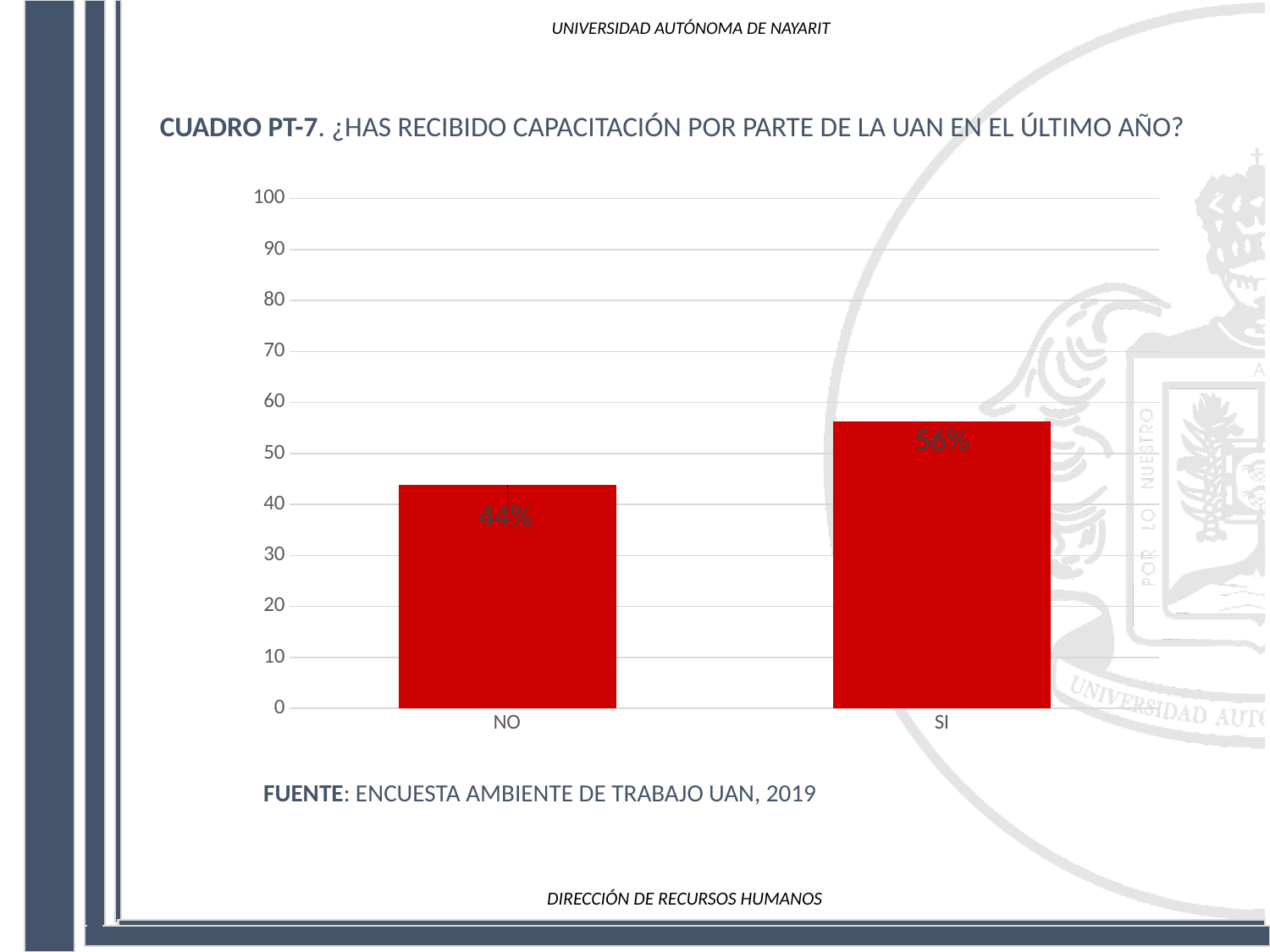
Which category has the lowest value? NO What is the highest value shown on the y axis? 100 What source is cited below the chart? ENCUESTA AMBIENTE DE TRABAJO UAN, 2019 How many categories are shown on the x axis? 2 Which category has the highest value? SI What kind of chart is shown on the slide? bar chart What is the value for NO? 44% What is the difference between the values for SI and NO? 12% Is the value for SI greater or less than 50? greater What is the value for SI? 56% Is the value for NO greater or less than 50? less Which is larger, the value for NO or the value for SI? SI